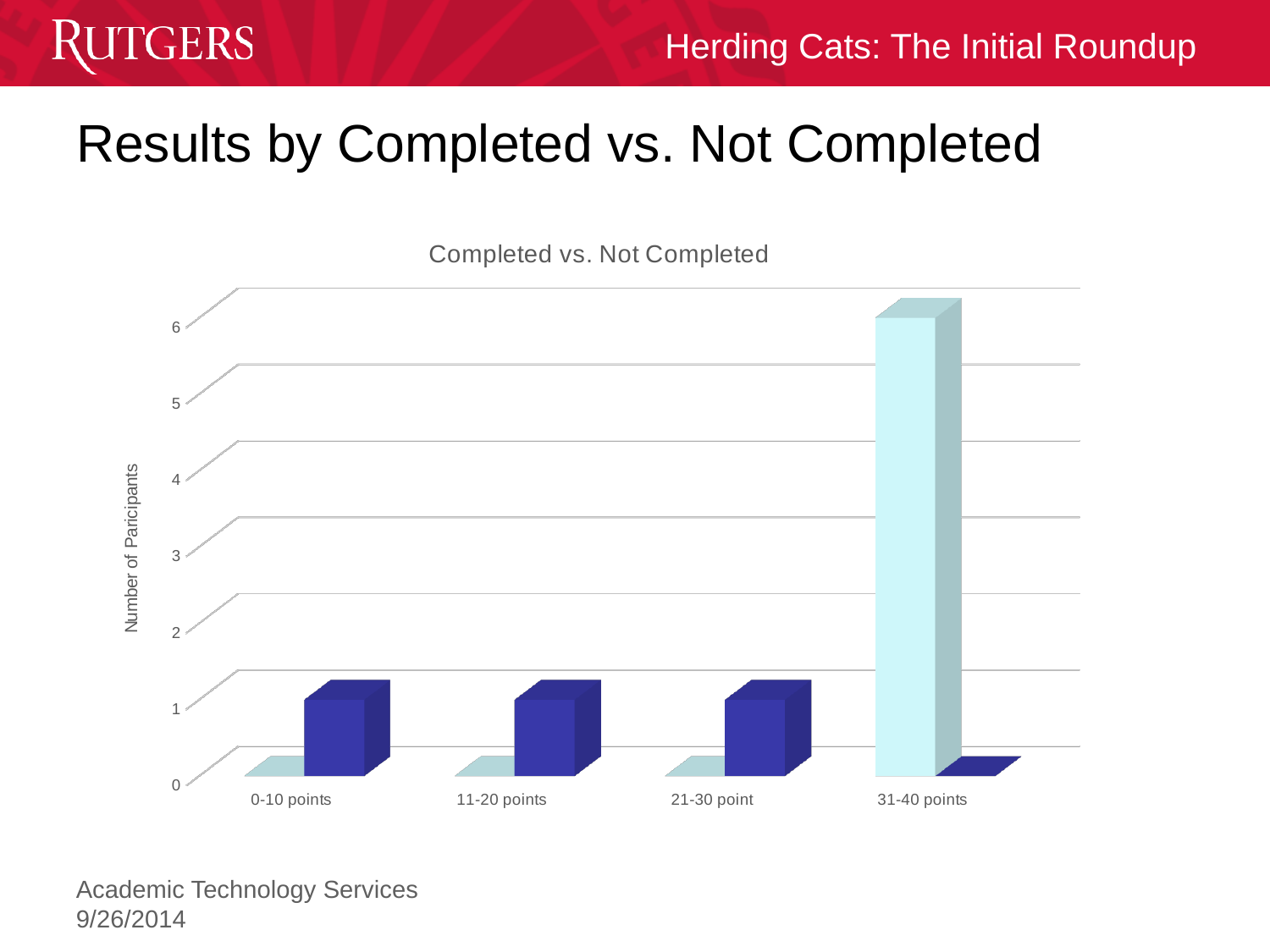
Is the value of the dark blue bar for 11-20 points greater or less than 3? less How many categories are shown on the x axis of the chart? 4 What is the value of the light blue bar for 31-40 points? 6 What is the highest value shown on the y axis of the chart? 6 Is the value of the dark blue bar for 0-10 points greater or less than 2? less Which category has the tallest bar in the chart? 31-40 points What is the title of the chart? Completed vs. Not Completed Which is larger: the light blue bar for 31-40 points or the dark blue bar for 21-30 point? the light blue bar for 31-40 points What is the label of the y axis of the chart? Number of Paricipants What kind of chart is shown on the slide? bar chart What is the value of the dark blue bar for 21-30 point? 1 Is the value of the light blue bar for 31-40 points greater or less than 5? greater